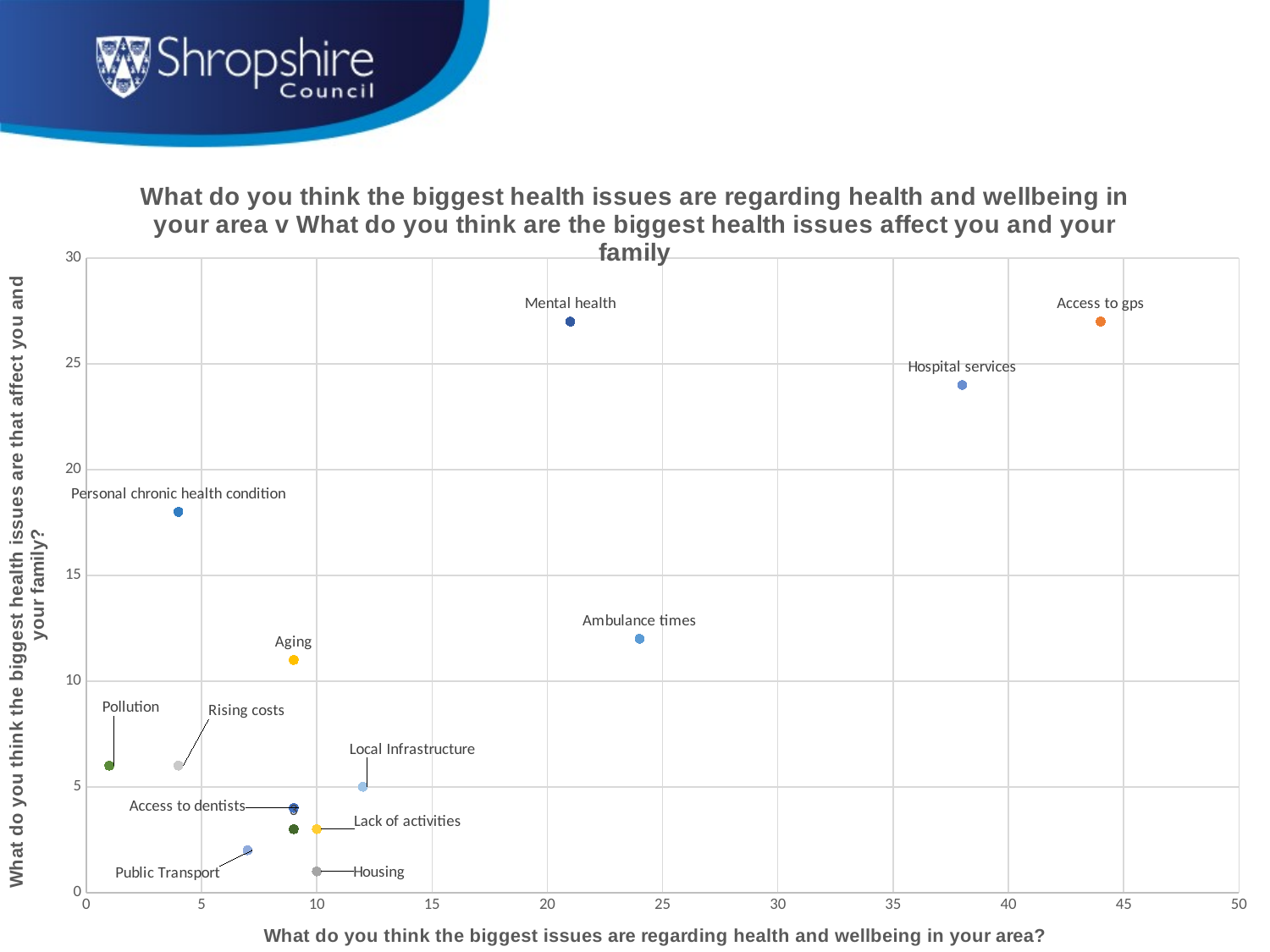
Which point has the lowest value on the y axis (issues affecting you and your family)? Housing Is the y-axis value for Mental health greater or less than 25? greater Is the y-axis value for Personal chronic health condition greater or less than 20? less Which point lies furthest to the left along the x axis? Pollution Which has the higher y-axis value, Hospital services or Ambulance times? Hospital services Is the x-axis value for Ambulance times greater or less than 20? greater What is the title of the x axis? What do you think the biggest issues are regarding health and wellbeing in your area? Which has the higher x-axis value, Access to gps or Mental health? Access to gps Which point lies furthest to the right along the x axis (highest value for 'biggest issues in your area')? Access to gps What kind of chart is shown on the slide? Scatter chart